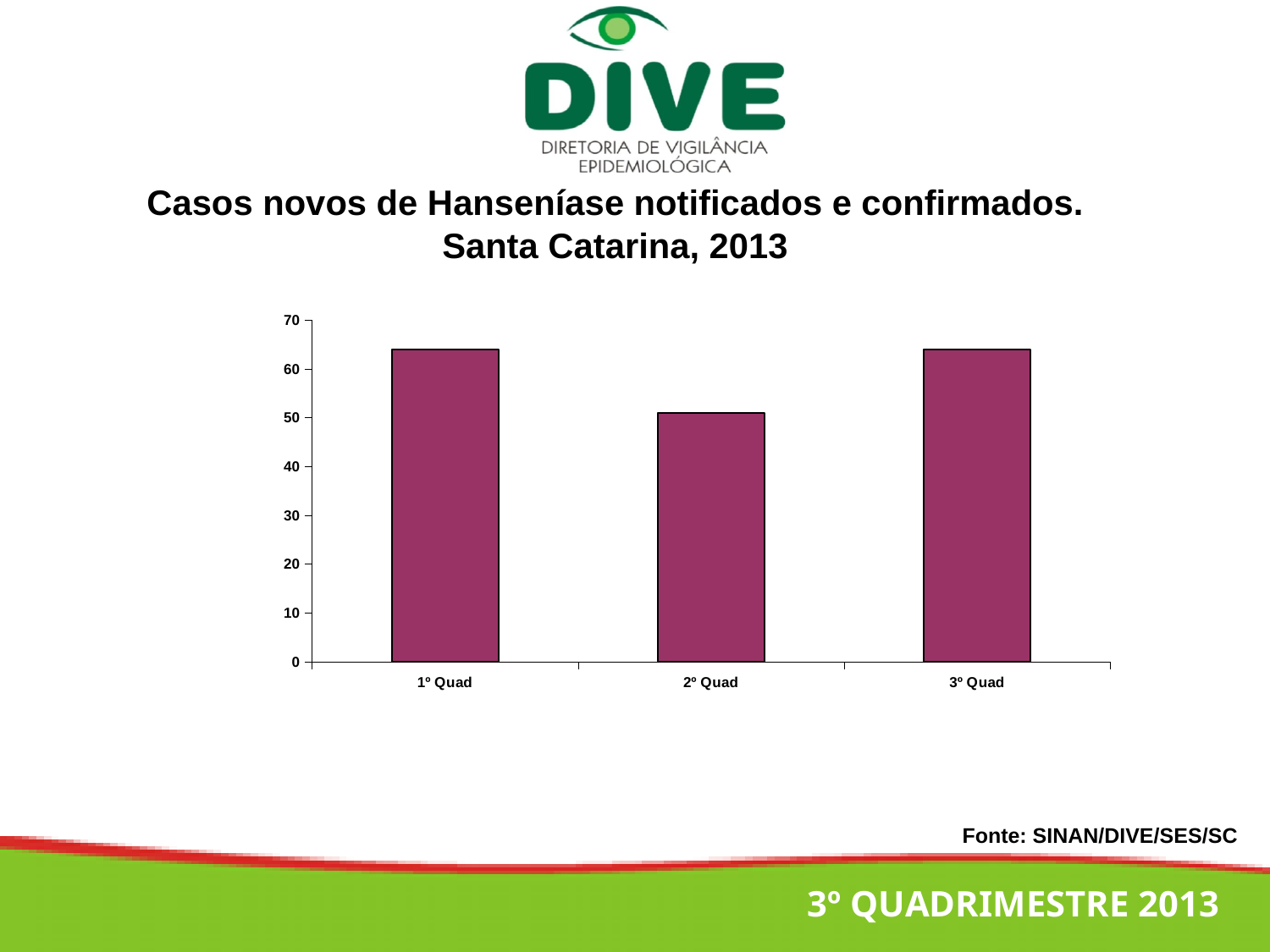
Which has the larger value, 1º Quad or 2º Quad? 1º Quad Which category has the lowest value in the chart? 2º Quad Is the value for 3º Quad greater or less than 60? greater Is the value for 1º Quad greater or less than 60? greater Is the value for 2º Quad greater or less than 60? less How many categories are shown on the x axis of the chart? 3 Which has the larger value, 2º Quad or 3º Quad? 3º Quad Does the value fall or rise from 1º Quad to 2º Quad? fall What is the title of the chart on the slide? Casos novos de Hanseníase notificados e confirmados. Santa Catarina, 2013 What is the highest value shown on the y axis of the chart? 70 What kind of chart is shown on the slide? bar chart